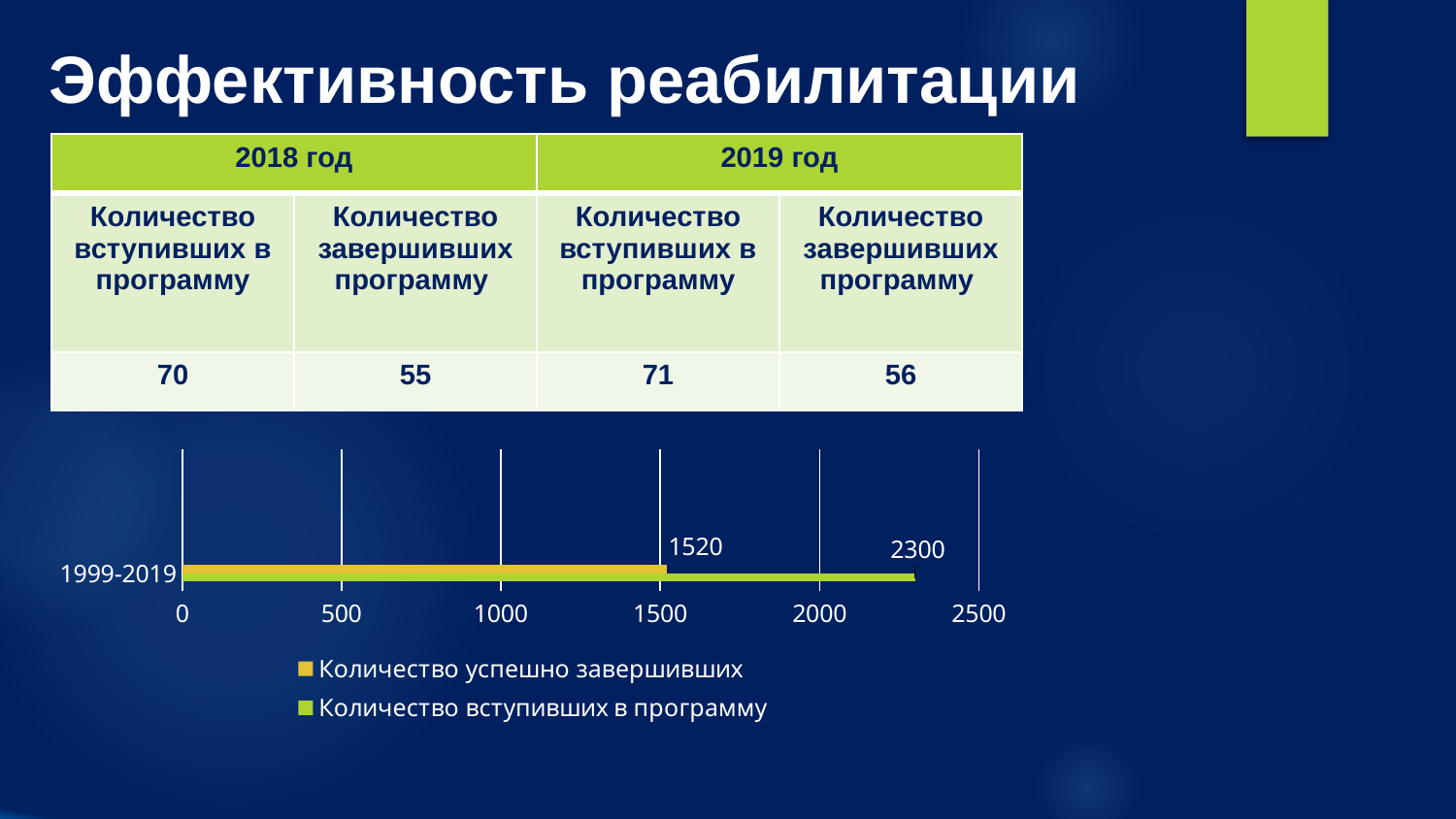
What is the difference between "Количество вступивших в программу" and "Количество успешно завершивших" for 1999-2019? 780 What type of chart is shown on the slide? bar chart Is the value for "Количество вступивших в программу" greater or less than 2500? less How many series does the legend list? 2 Which series has the lowest value in the chart? Количество успешно завершивших Which series has the higher value for 1999-2019? Количество вступивших в программу What is the maximum value shown on the chart's horizontal axis? 2500 What is the value for "Количество вступивших в программу" for 1999-2019? 2300 What is the category label shown on the chart's vertical axis? 1999-2019 How many categories are shown on the vertical axis of the chart? 1 What is the value for "Количество успешно завершивших" for 1999-2019? 1520 Is the value for "Количество успешно завершивших" greater or less than 1500? greater